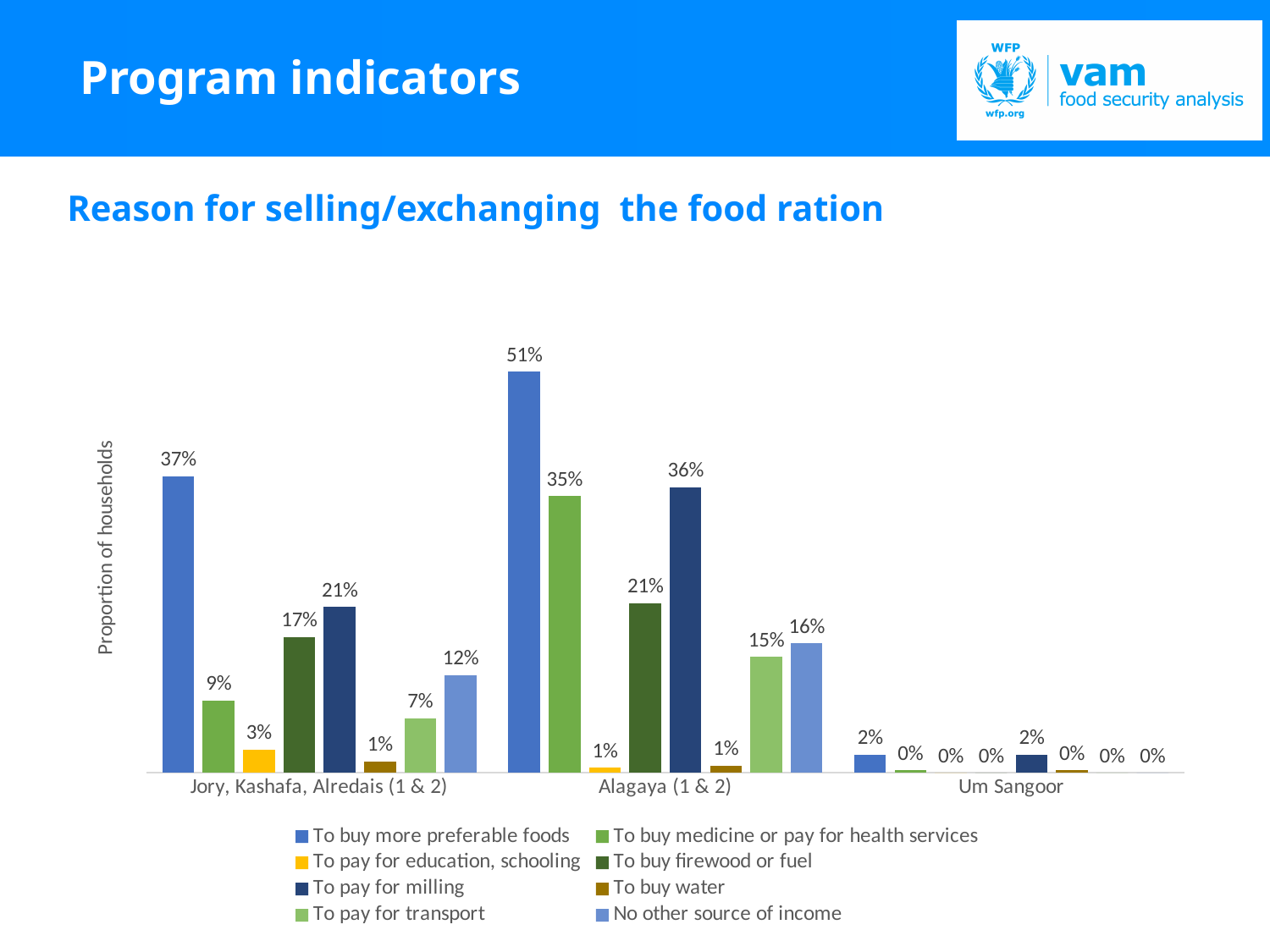
What is the value for "To buy more preferable foods" in Alagaya (1 & 2)? 51% Which is larger in Alagaya (1 & 2): "To buy medicine or pay for health services" or "To buy firewood or fuel"? To buy medicine or pay for health services What is the title of the chart? Reason for selling/exchanging the food ration How many location groups are shown on the x axis? 3 What is the value for "To pay for milling" in Jory, Kashafa, Alredais (1 & 2)? 21% Which reason has the lowest value in Jory, Kashafa, Alredais (1 & 2)? To buy water How many series does the legend list? 8 What is the difference between "To buy more preferable foods" in Alagaya (1 & 2) and in Jory, Kashafa, Alredais (1 & 2)? 14% What is the value for "To pay for transport" in Alagaya (1 & 2)? 15% What kind of chart is shown on the slide? Bar chart Which reason has the highest value in Alagaya (1 & 2)? To buy more preferable foods What is the value for "No other source of income" in Jory, Kashafa, Alredais (1 & 2)? 12%